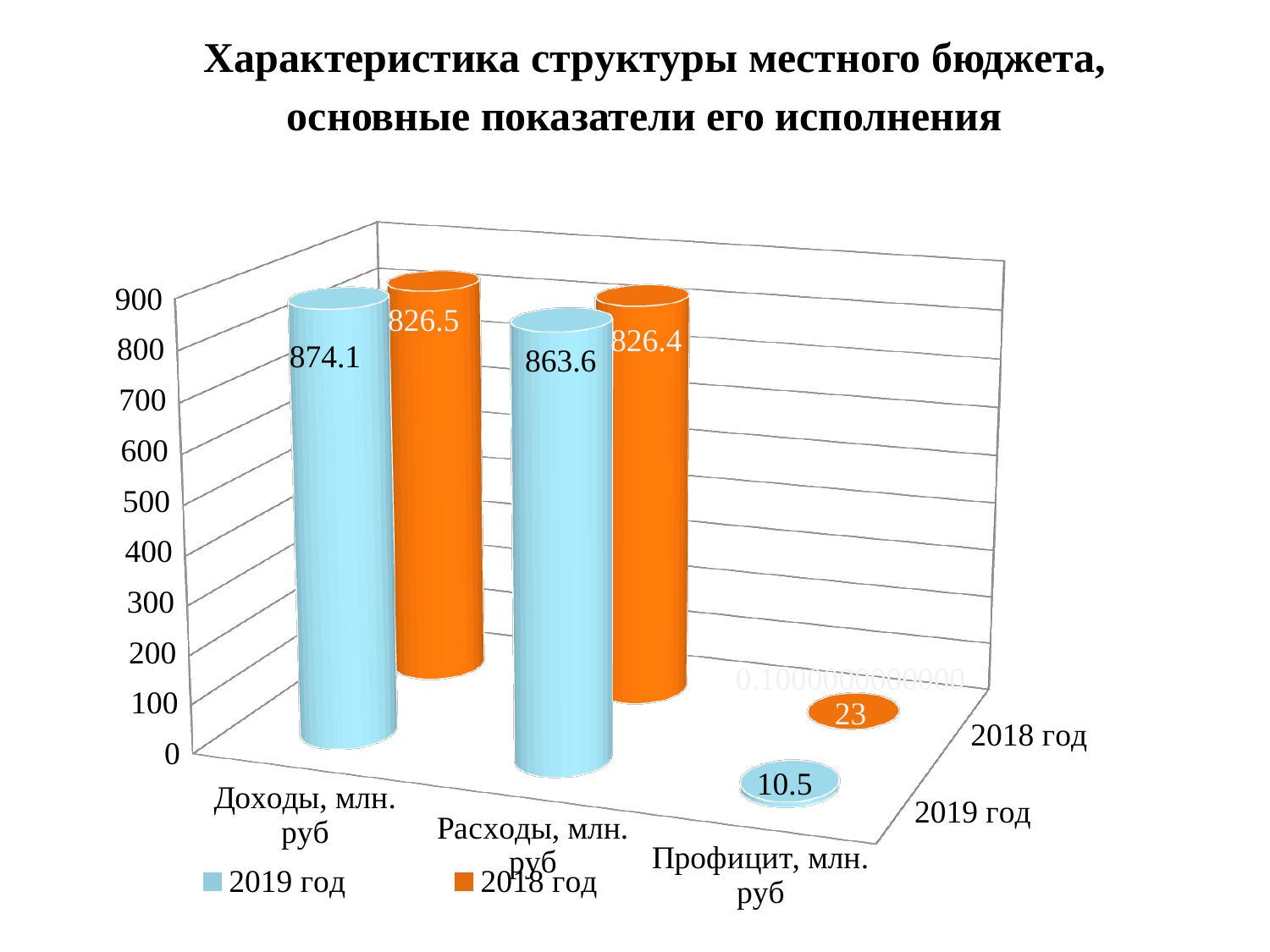
Which category has the lowest value in the 2018 год series? Профицит, млн. руб What is the value for Доходы, млн. руб in the 2019 год series? 874.1 What is the value for Расходы, млн. руб in the 2018 год series? 826.4 How many categories are shown on the x axis? 3 What is the difference between the 2019 год and 2018 год values for Доходы, млн. руб? 47.6 How many series does the legend list? 2 Which colour represents the 2018 год series? Orange What kind of chart is shown on the slide? Bar chart What is the value for Профицит, млн. руб in the 2019 год series? 10.5 Which category has the highest value in the 2019 год series? Доходы, млн. руб